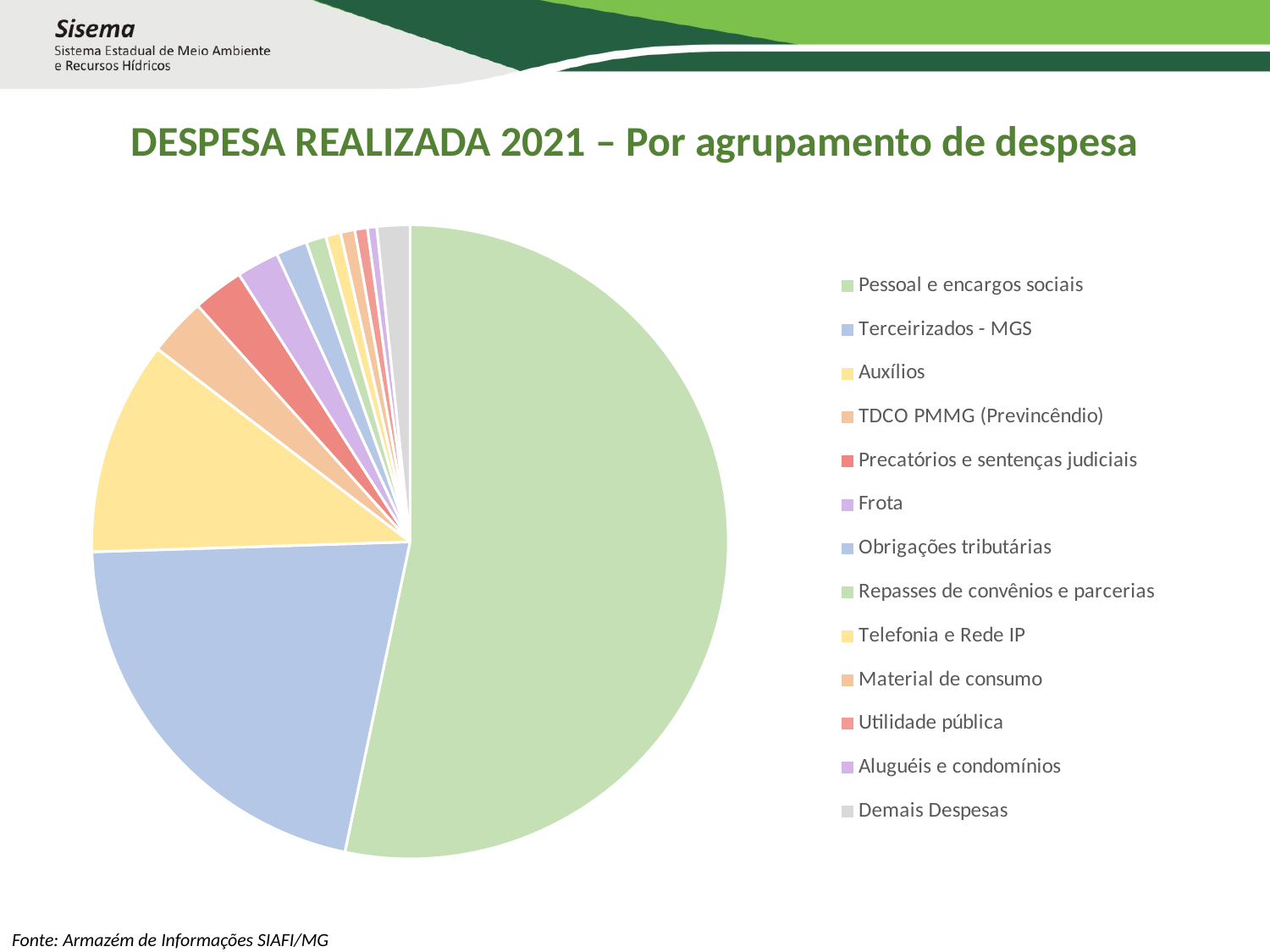
What source is cited for the chart's data? Armazém de Informações SIAFI/MG Which expense category has the largest slice of the pie? Pessoal e encargos sociais How many expense categories does the pie chart's legend list? 13 What kind of chart is shown on the slide? pie chart Which expense category has the second-largest slice of the pie? Terceirizados - MGS Does the slice for Pessoal e encargos sociais account for more or less than half of the pie? more Which slice is larger: Terceirizados - MGS or Auxílios? Terceirizados - MGS Which slice is larger: Auxílios or Frota? Auxílios Which expense category has the third-largest slice of the pie? Auxílios Which slice is larger: Auxílios or TDCO PMMG (Previncêndio)? Auxílios What is the title of the chart on the slide? DESPESA REALIZADA 2021 – Por agrupamento de despesa